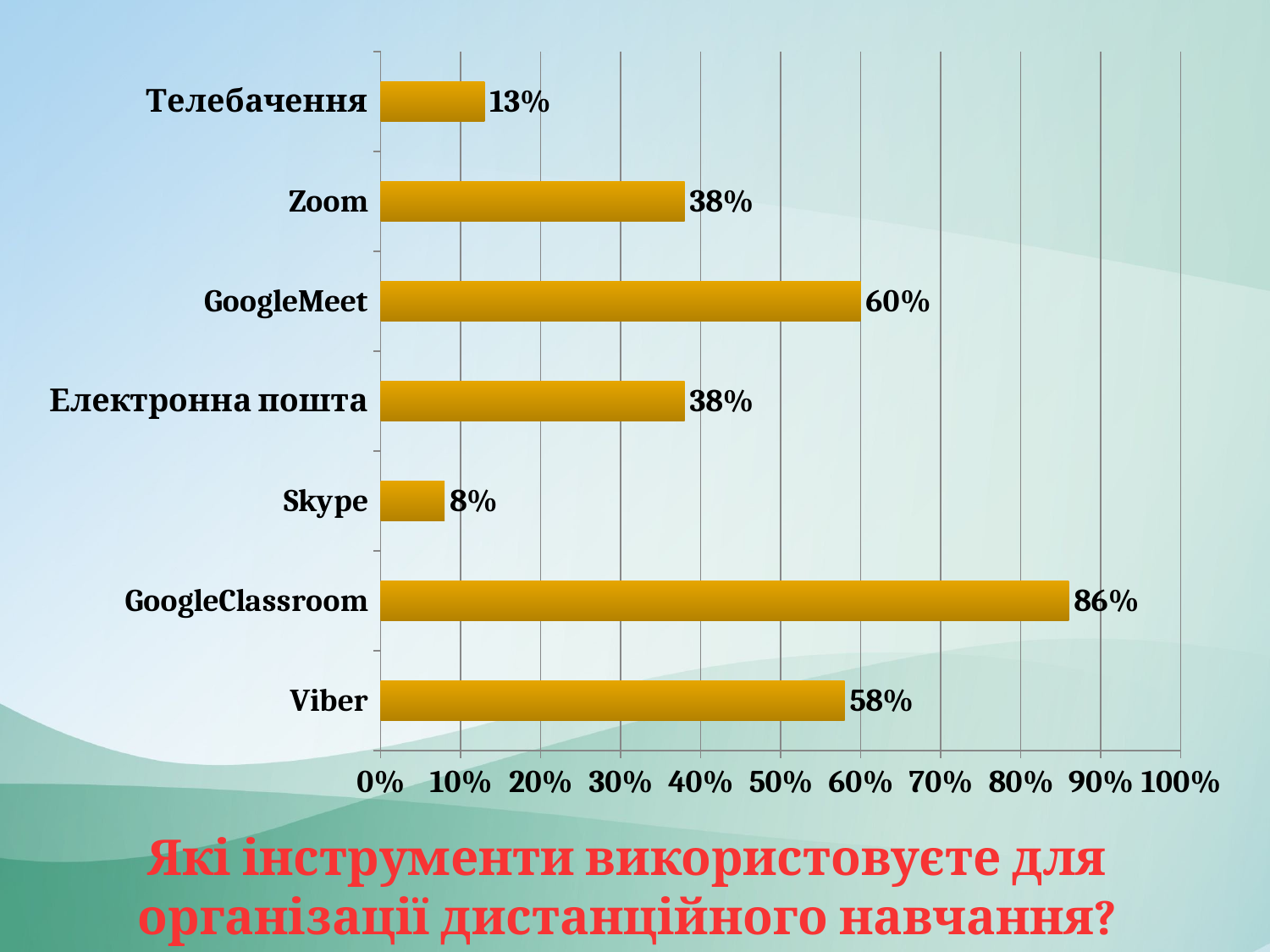
What is the value for Viber? 58% Which category has the highest value? GoogleClassroom What is the value for GoogleClassroom? 86% Is the value for GoogleMeet greater or less than 50%? greater What is the difference between the values for Zoom and Skype? 30% What kind of chart is shown on the slide? Bar chart Which category has the lowest value? Skype What is the value for Телебачення? 13% What is the title text shown below the chart? Які інструменти використовуєте для організації дистанційного навчання? How many categories are shown in the chart? 7 Which is larger, the value for Viber or the value for Zoom? Viber What is the difference between the values for GoogleClassroom and GoogleMeet? 26%